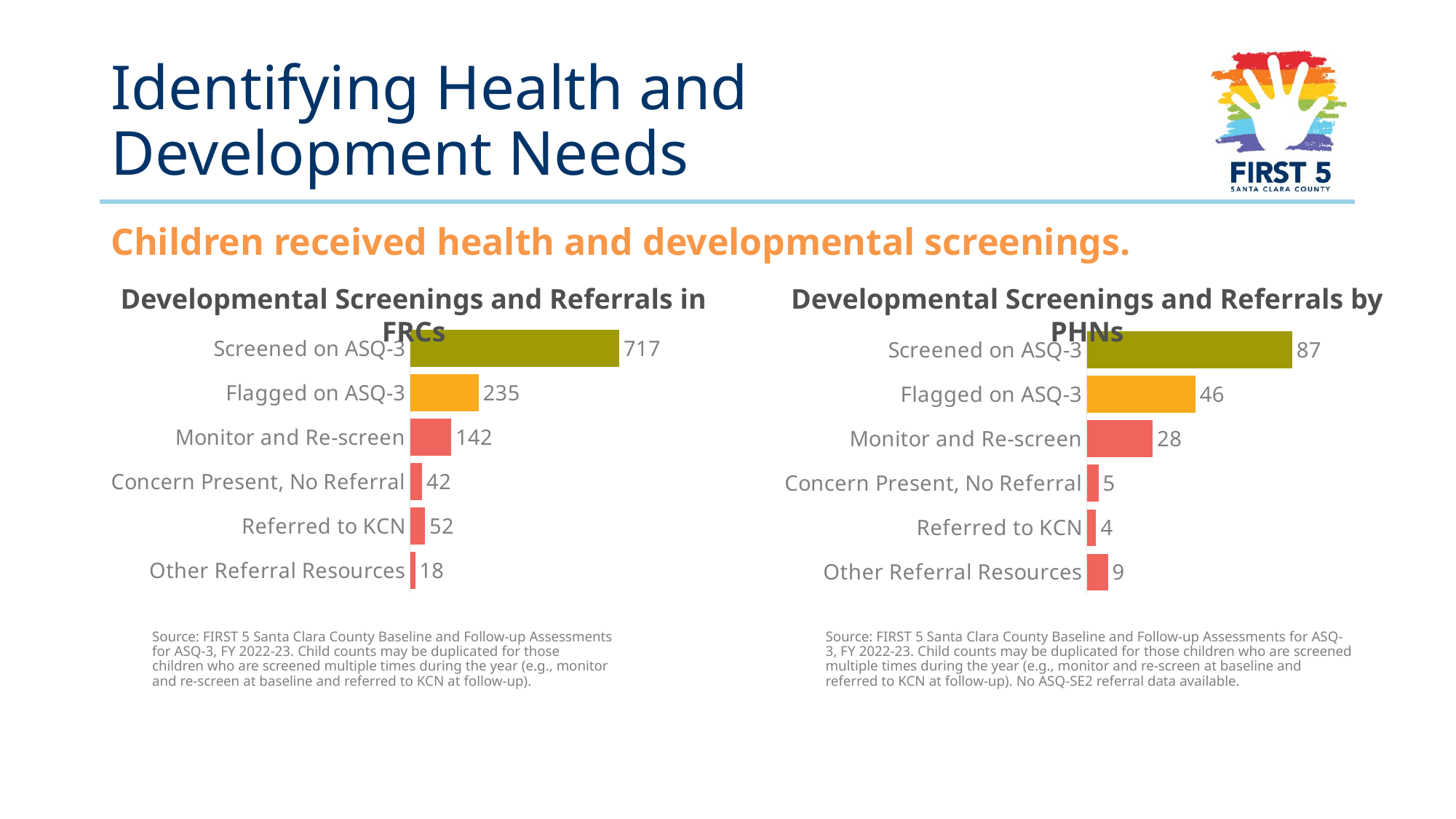
In the 'Developmental Screenings and Referrals by PHNs' chart, which category has the lowest value? Referred to KCN In the 'Developmental Screenings and Referrals by PHNs' chart, which category has the highest value? Screened on ASQ-3 In the 'Developmental Screenings and Referrals in FRCs' chart, which is larger: Referred to KCN or Concern Present, No Referral? Referred to KCN In the 'Developmental Screenings and Referrals in FRCs' chart, which category has the lowest value? Other Referral Resources In the 'Developmental Screenings and Referrals in FRCs' chart, what is the value for Monitor and Re-screen? 142 In the 'Developmental Screenings and Referrals in FRCs' chart, what is the difference between Screened on ASQ-3 and Flagged on ASQ-3? 482 In the 'Developmental Screenings and Referrals by PHNs' chart, what is the value for Flagged on ASQ-3? 46 In the 'Developmental Screenings and Referrals in FRCs' chart, what is the value for Screened on ASQ-3? 717 What type of chart is the 'Developmental Screenings and Referrals in FRCs' chart? Bar chart In the 'Developmental Screenings and Referrals by PHNs' chart, what is the value for Other Referral Resources? 9 How many categories are shown in the 'Developmental Screenings and Referrals by PHNs' chart? 6 In the 'Developmental Screenings and Referrals by PHNs' chart, what is the difference between Flagged on ASQ-3 and Monitor and Re-screen? 18